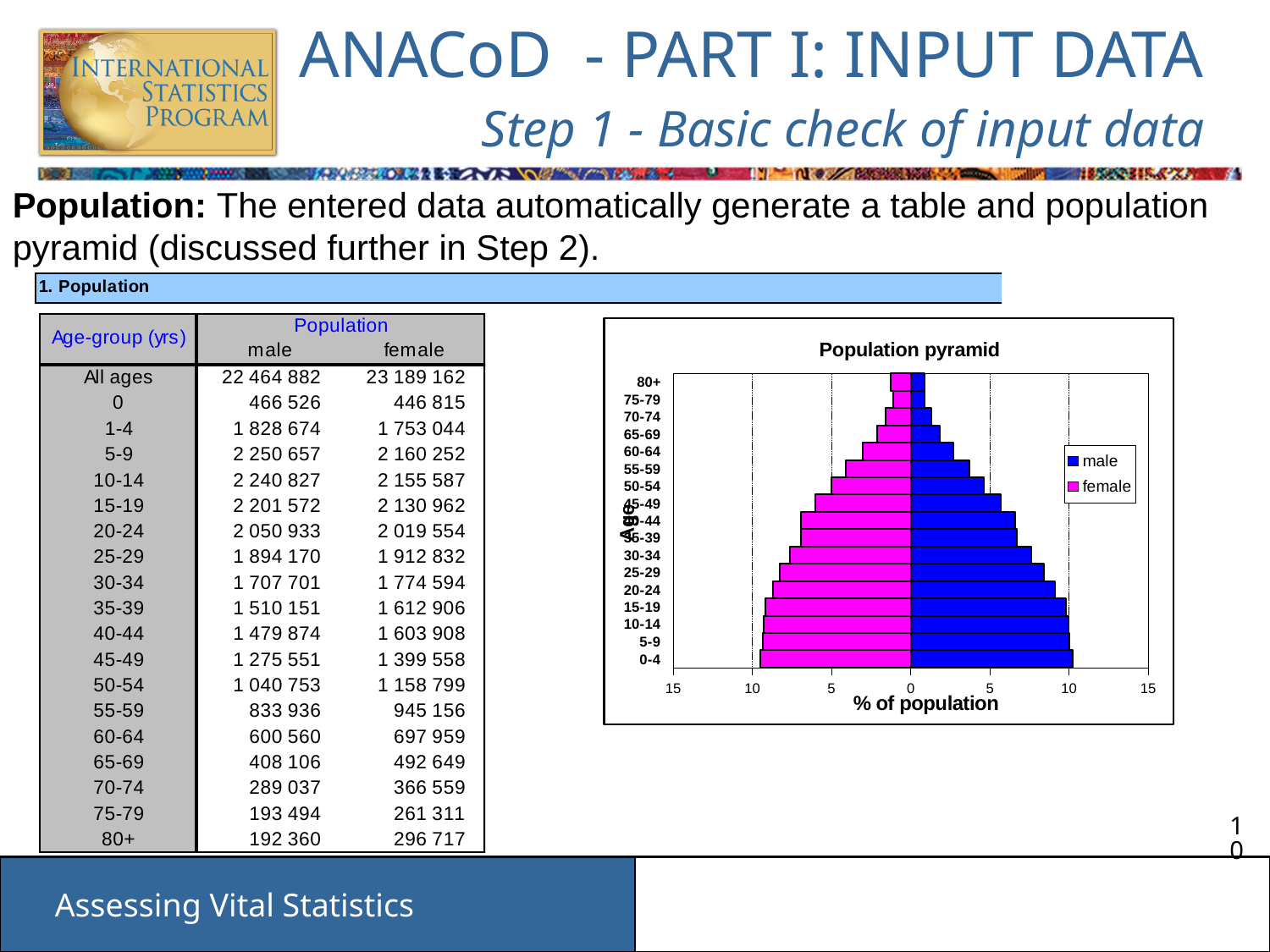
In the Population pyramid, which is larger for males: the 0-4 age group or the 80+ age group? 0-4 How many age-group categories are shown on the Population pyramid? 17 In the Population pyramid, is the male value for the 80+ age group greater or less than 5? less In the Population pyramid, is the female value for the 60-64 age group greater or less than 5? less In the Population pyramid, do the bars generally get shorter or longer as the age group increases from 0-4 to 80+? shorter What is the title of the chart on the slide? Population pyramid What is the label of the horizontal axis of the Population pyramid? % of population In the Population pyramid, is the male value for the 0-4 age group greater or less than 5? greater What kind of chart is the Population pyramid? bar chart How many series does the legend of the Population pyramid list? 2